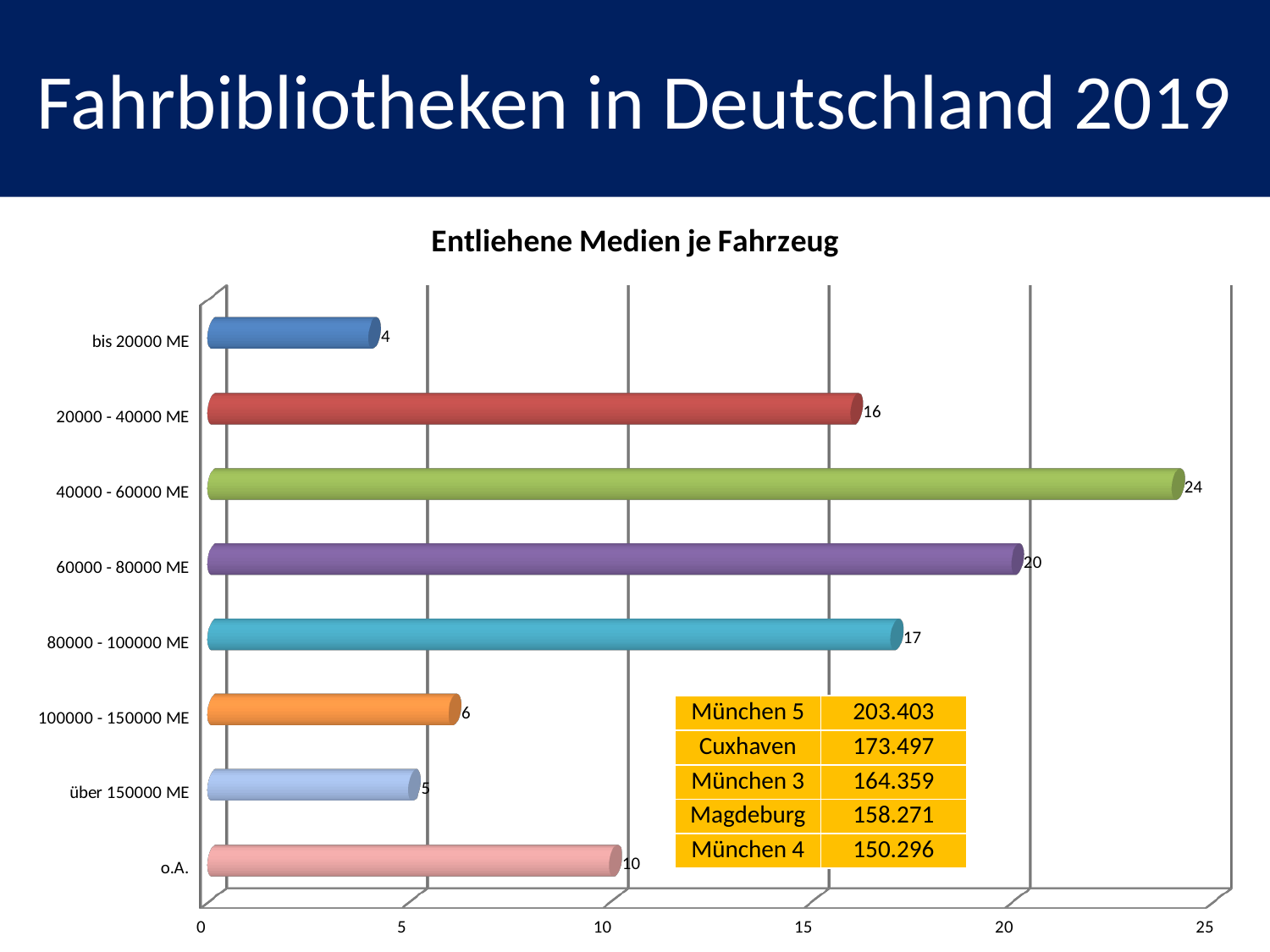
Which is larger, the value for "20000 - 40000 ME" or the value for "100000 - 150000 ME"? 20000 - 40000 ME What is the value for the category "bis 20000 ME"? 4 What is the difference between the values for "60000 - 80000 ME" and "80000 - 100000 ME"? 3 Which category has the lowest value? bis 20000 ME How many categories are shown in the chart? 8 What is the value for "über 150000 ME"? 5 What is the value for the category "40000 - 60000 ME"? 24 What kind of chart is shown on the slide? bar chart Is the value for "60000 - 80000 ME" greater or less than 15? greater What is the value for the category "o.A."? 10 Which category has the highest value? 40000 - 60000 ME What is the title of the chart? Entliehene Medien je Fahrzeug